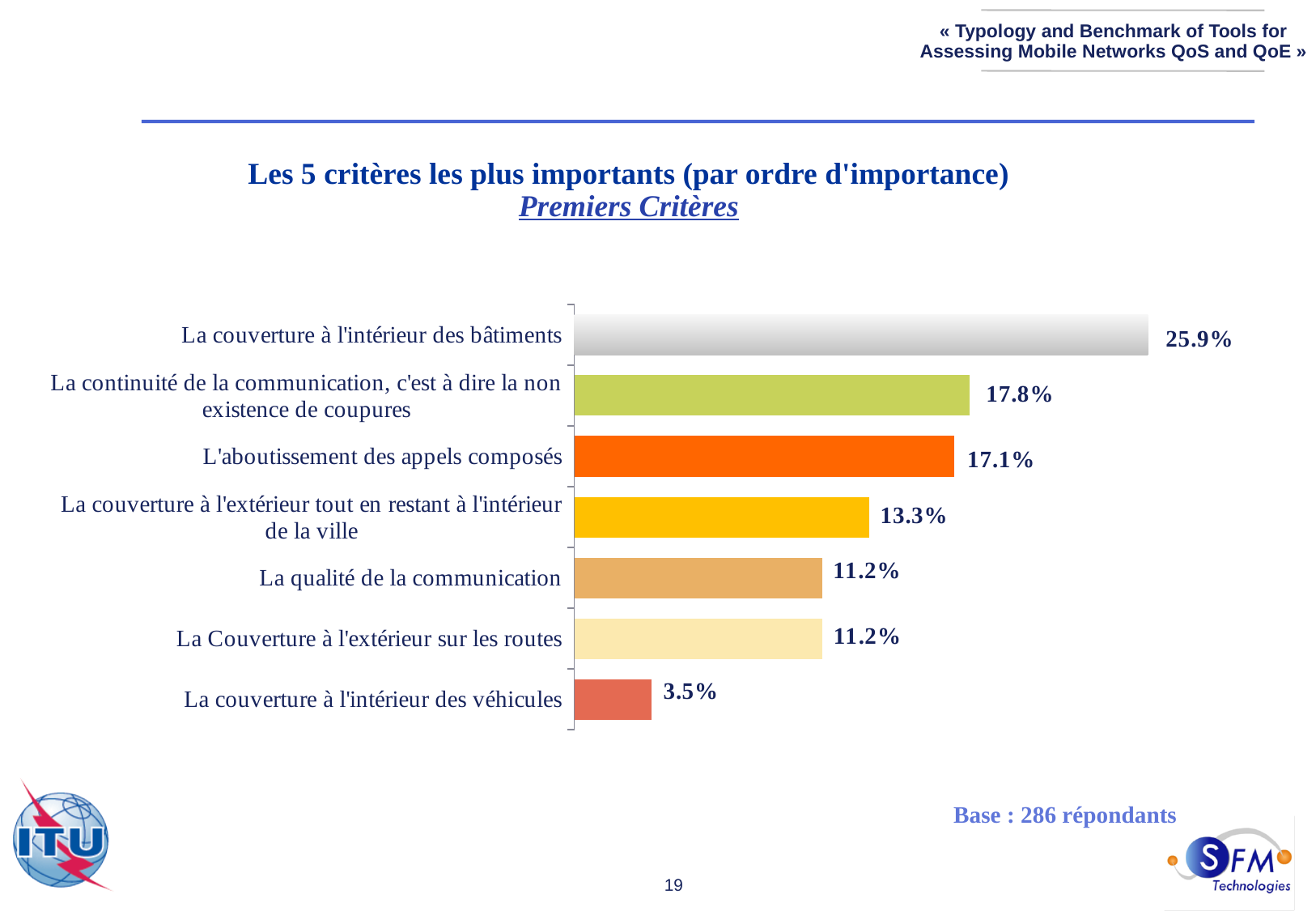
What is the difference between the values for "La couverture à l'intérieur des bâtiments" and "La continuité de la communication, c'est à dire la non existence de coupures"? 8.1% Which is larger: the value for "La continuité de la communication, c'est à dire la non existence de coupures" or for "L'aboutissement des appels composés"? La continuité de la communication, c'est à dire la non existence de coupures What is the value for "L'aboutissement des appels composés"? 17.1% What is the base number of respondents stated on the slide? 286 répondants What is the value for "La couverture à l'intérieur des véhicules"? 3.5% What is the value for "La qualité de la communication"? 11.2% What is the difference between the values for "La couverture à l'extérieur tout en restant à l'intérieur de la ville" and "La couverture à l'intérieur des véhicules"? 9.8% How many categories are shown in the chart? 7 Which category has the highest value? La couverture à l'intérieur des bâtiments What kind of chart is shown on the slide? Bar chart What is the value for "La couverture à l'intérieur des bâtiments"? 25.9% Which category has the lowest value? La couverture à l'intérieur des véhicules